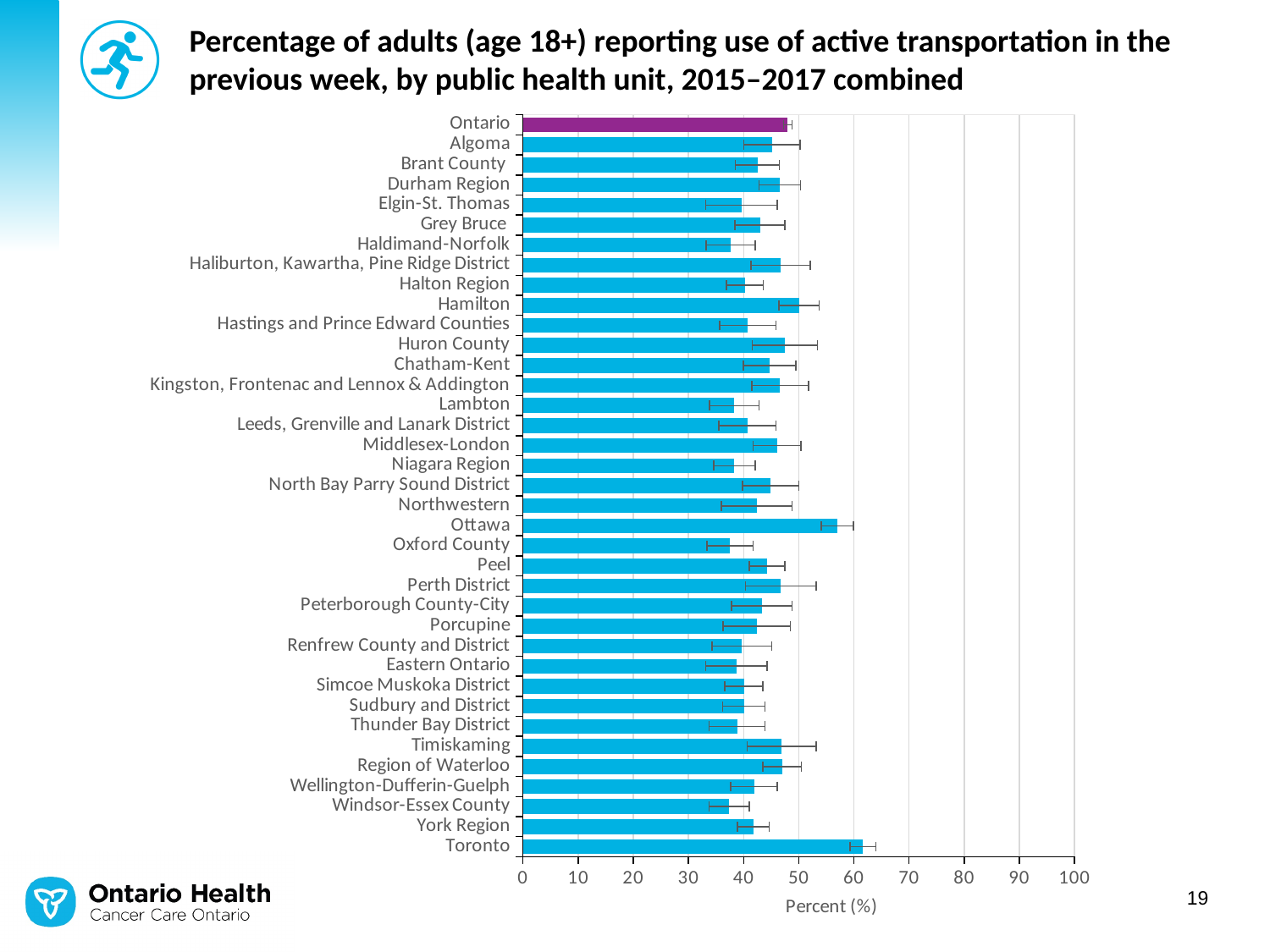
Is the value for Ontario greater or less than 40? greater Which has a higher percentage, Toronto or Ottawa? Toronto Is the value for Toronto greater or less than 50? greater Is the value for Haldimand-Norfolk greater or less than 40? less Which has a higher percentage, Ottawa or Hamilton? Ottawa How many bars are plotted in the chart, including Ontario? 37 What is the label of the horizontal axis? Percent (%) What is the maximum value shown on the horizontal axis? 100 Which public health unit has the highest percentage of adults reporting use of active transportation? Toronto What kind of chart is shown on the slide? bar chart